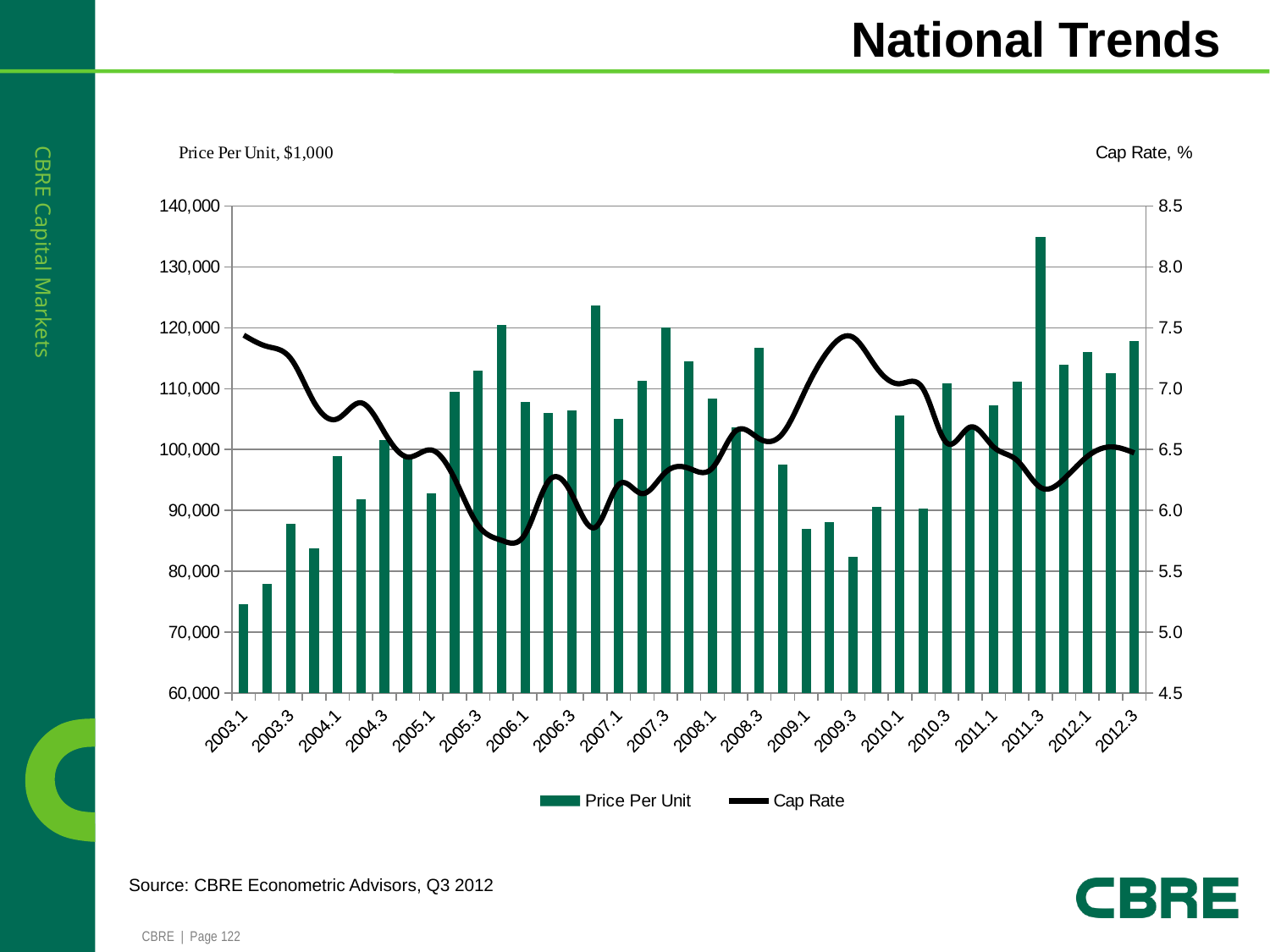
How many series does the legend list? 2 Is the Cap Rate value for 2009.3 greater or less than 7.0? greater What is the label of the left vertical axis? Price Per Unit, $1,000 What kind of chart is shown on the slide? A combined bar and line chart Does the Cap Rate line rise or fall from 2003.1 to 2006.1? fall Is the Cap Rate value for 2012.3 greater or less than 7.0? less In which quarter is the Price Per Unit bar the lowest? 2003.1 Is the Price Per Unit value for 2011.3 greater or less than 130,000? greater Which series is drawn as a line in the chart? Cap Rate In which quarter is the Price Per Unit bar the highest? 2011.3 Which quarter has the larger Price Per Unit, 2007.1 or 2009.1? 2007.1